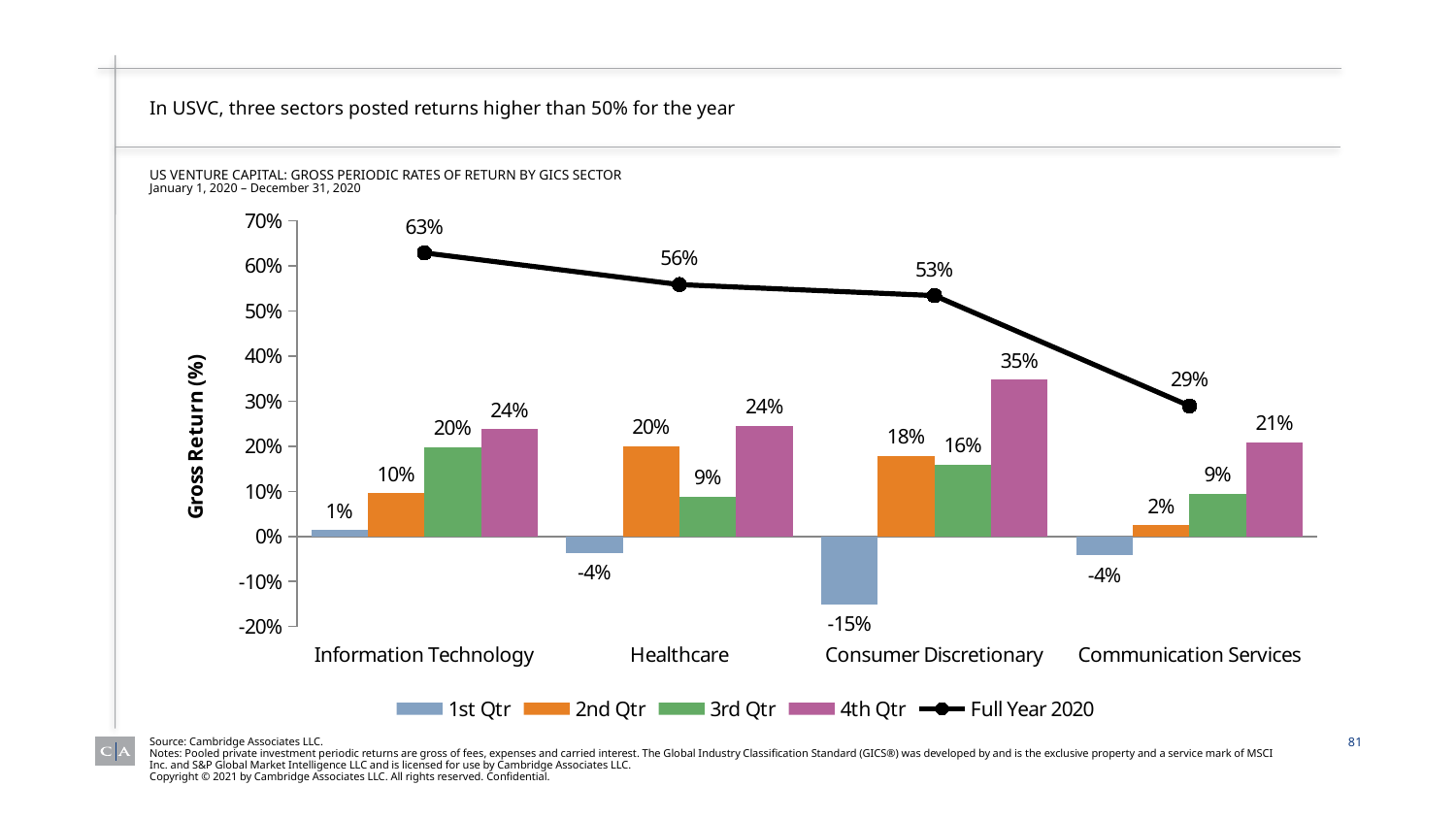
How many series does the legend list? 5 Does the Full Year 2020 line rise or fall from Information Technology to Communication Services? Fall How many sectors are shown on the x axis? 4 What is the 4th Qtr gross return for Communication Services? 21% Which sector has the lowest 1st Qtr return? Consumer Discretionary Which is larger, the 4th Qtr return for Consumer Discretionary or the 4th Qtr return for Healthcare? Consumer Discretionary What is the 1st Qtr gross return for Consumer Discretionary? -15% What is the difference between the Full Year 2020 returns for Healthcare and Communication Services? 27% What is the label of the y axis? Gross Return (%) What is the Full Year 2020 gross return for Information Technology? 63% What kind of chart is this? Combined bar and line chart Which sector has the highest Full Year 2020 return? Information Technology